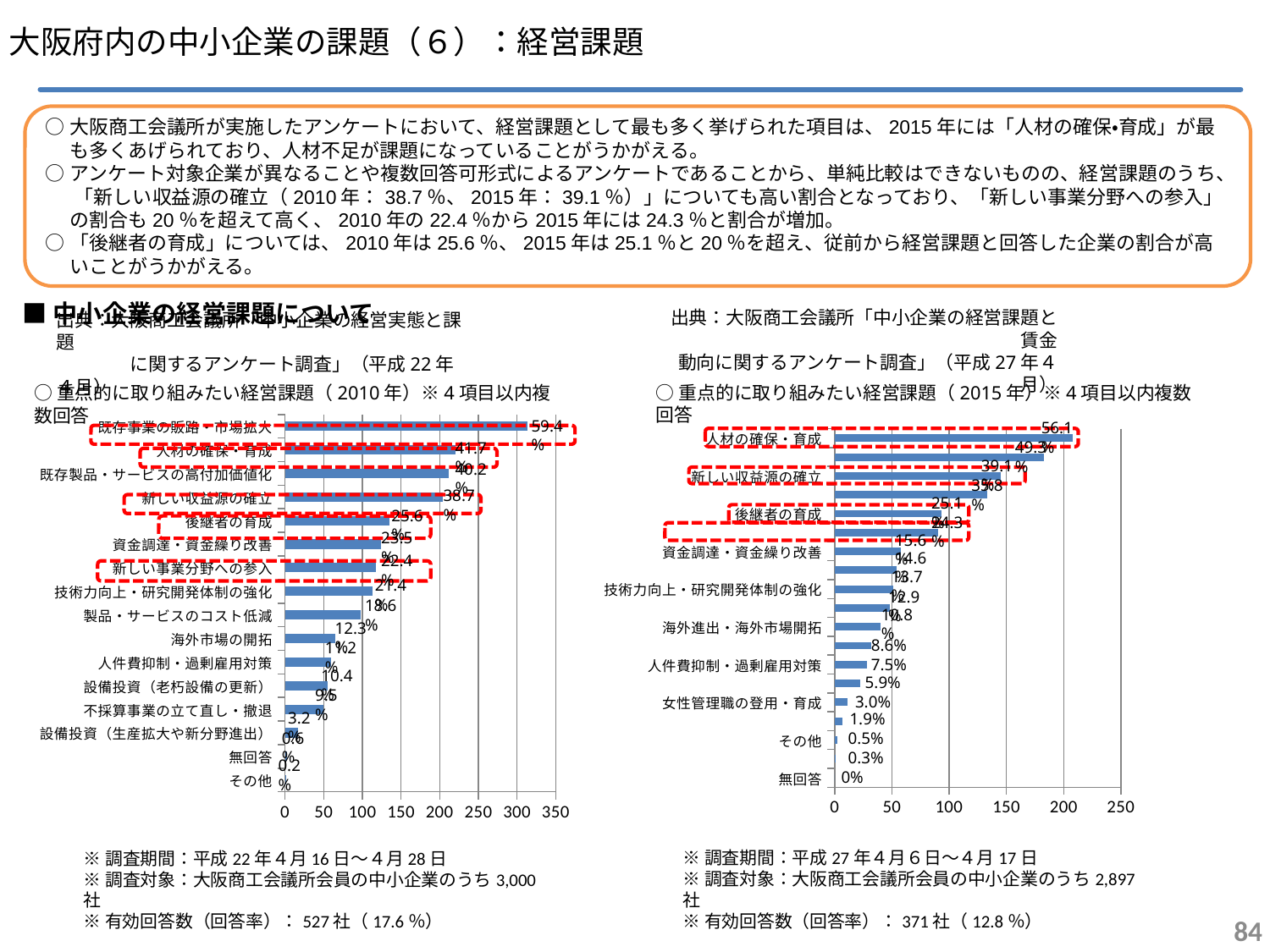
In the right (2015) chart, which category has the lowest value? 無回答 In the right (2015) chart, what is the data label for 新しい収益源の確立? 39.1% In the left (2010) chart, what is the data label for 新しい収益源の確立? 38.7% In the left (2010) chart, which category has the highest value? 既存事業の販路・市場拡大 Which is larger: the label for 後継者の育成 in the left (2010) chart or in the right (2015) chart? 2010 (25.6%) In the left (2010) chart, what is the data label for 既存事業の販路・市場拡大? 59.4% In the left (2010) chart, what is the data label for 後継者の育成? 25.6% In the right (2015) chart, what is the difference between the labels for 人材の確保・育成 and 新しい収益源の確立? 17.0% What type of chart is used on the left (2010) chart? bar chart In the right (2015) chart, which category has the highest value? 人材の確保・育成 What is the maximum value shown on the x axis of the right (2015) chart? 250 In the right (2015) chart, what is the data label for 人材の確保・育成? 56.1%